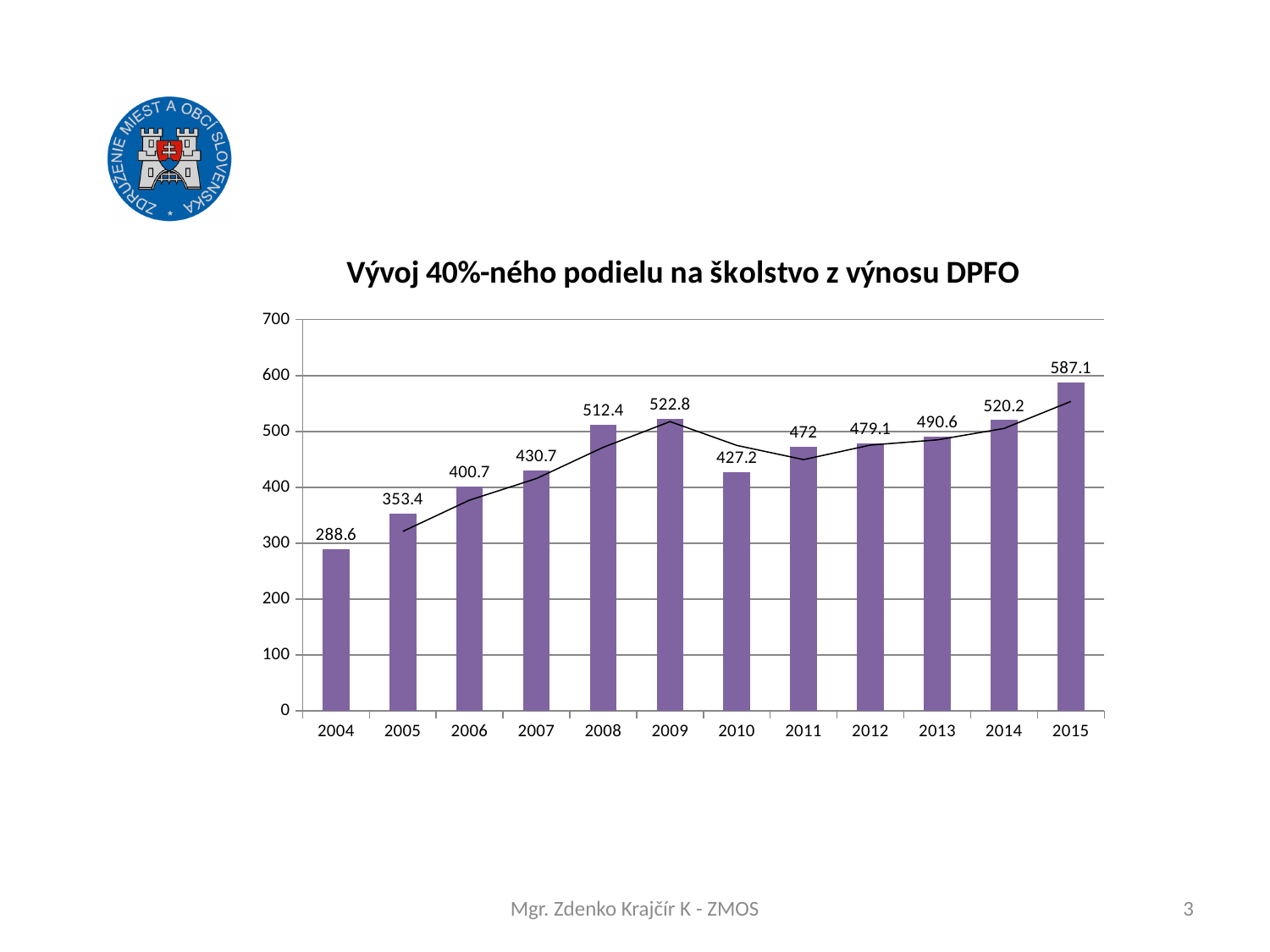
What is the title of the chart? Vývoj 40%-ného podielu na školstvo z výnosu DPFO How many years are shown on the x axis? 12 Is the value for 2011 greater or less than 500? less What is the difference between the values for 2009 and 2010? 95.6 What is the value for 2004? 288.6 What kind of chart is this? bar chart What is the value for 2015? 587.1 Which is larger, the value for 2009 or the value for 2013? 2009 What is the difference between the values for 2015 and 2014? 66.9 What is the value for 2010? 427.2 Which year has the lowest value? 2004 Which year has the highest value? 2015